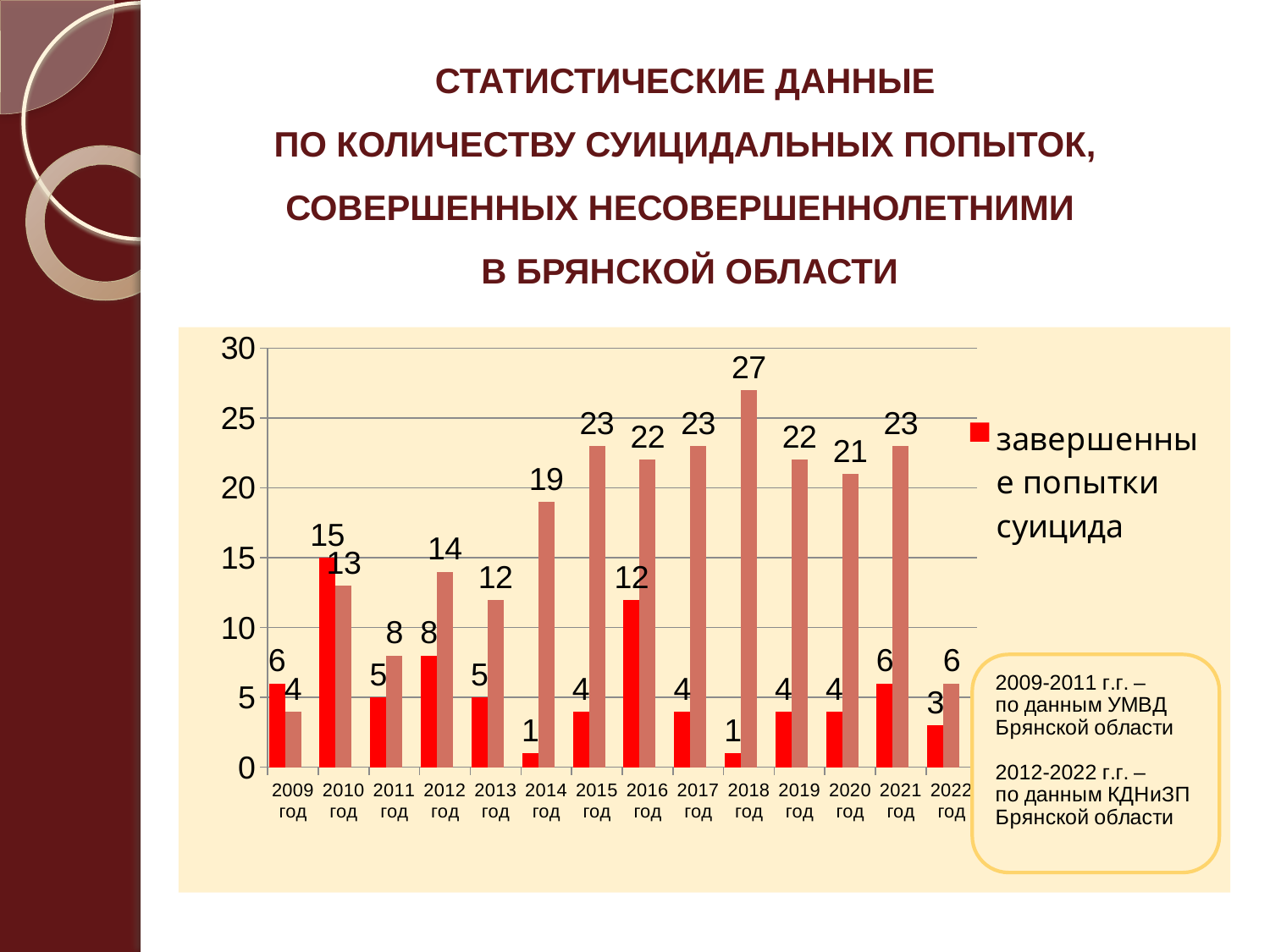
In which year is the lighter brown bar the highest? 2018 год In which year is the red bar (завершенные попытки суицида) the highest? 2010 год What is the value of the red bar (завершенные попытки суицида) for 2010 год? 15 What is the value of the red bar (завершенные попытки суицида) for 2022 год? 3 What is the value of the lighter brown bar for 2018 год? 27 What is the difference between the lighter brown bar and the red bar for 2016 год? 10 Is the value of the lighter brown bar for 2015 год greater or less than 20? greater What type of chart is shown on the slide? bar chart How many years are shown on the x axis of the chart? 14 For 2012 год, which is larger: the red bar or the lighter brown bar? the lighter brown bar What is the label of the series shown in the legend? завершенные попытки суицида In which year is the lighter brown bar the lowest? 2009 год